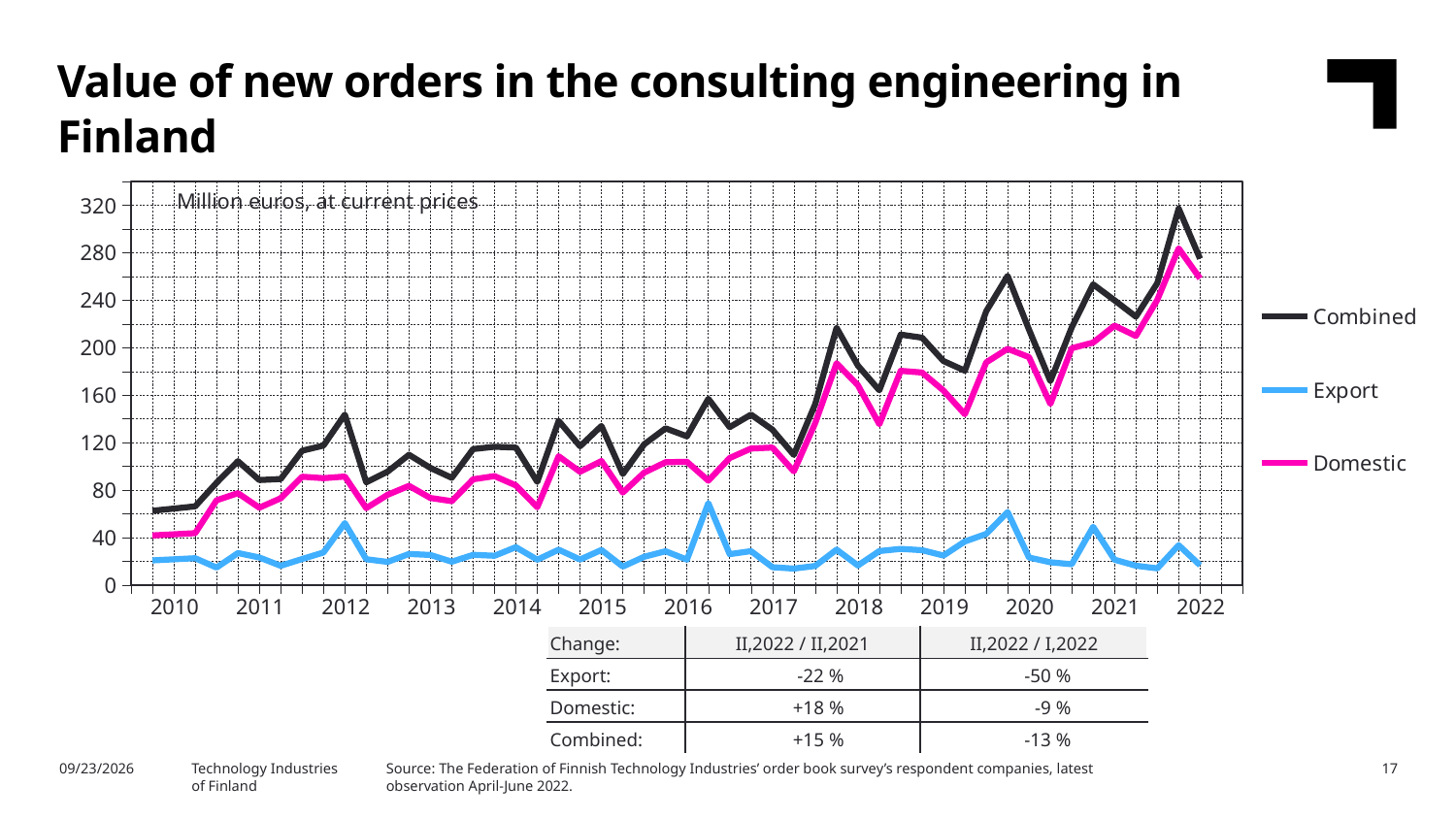
How many series does the chart's legend list? 3 Is the peak value of the Combined series in late 2021 greater or less than 280? greater Which series has the lowest values throughout the chart? Export Which series has the highest values throughout the chart? Combined Is the value of the Domestic series at the start of 2010 greater or less than 80? less Is the value of the Export series at the last point in 2022 greater or less than 40? less What are the three series named in the chart's legend? Combined, Export, Domestic At the last point in 2022, which is larger: the Domestic value or the Export value? Domestic Overall, does the Combined series rise or fall from 2010 to 2022? rise What unit is stated at the top of the chart area? Million euros, at current prices What type of chart is shown on the slide? Line chart